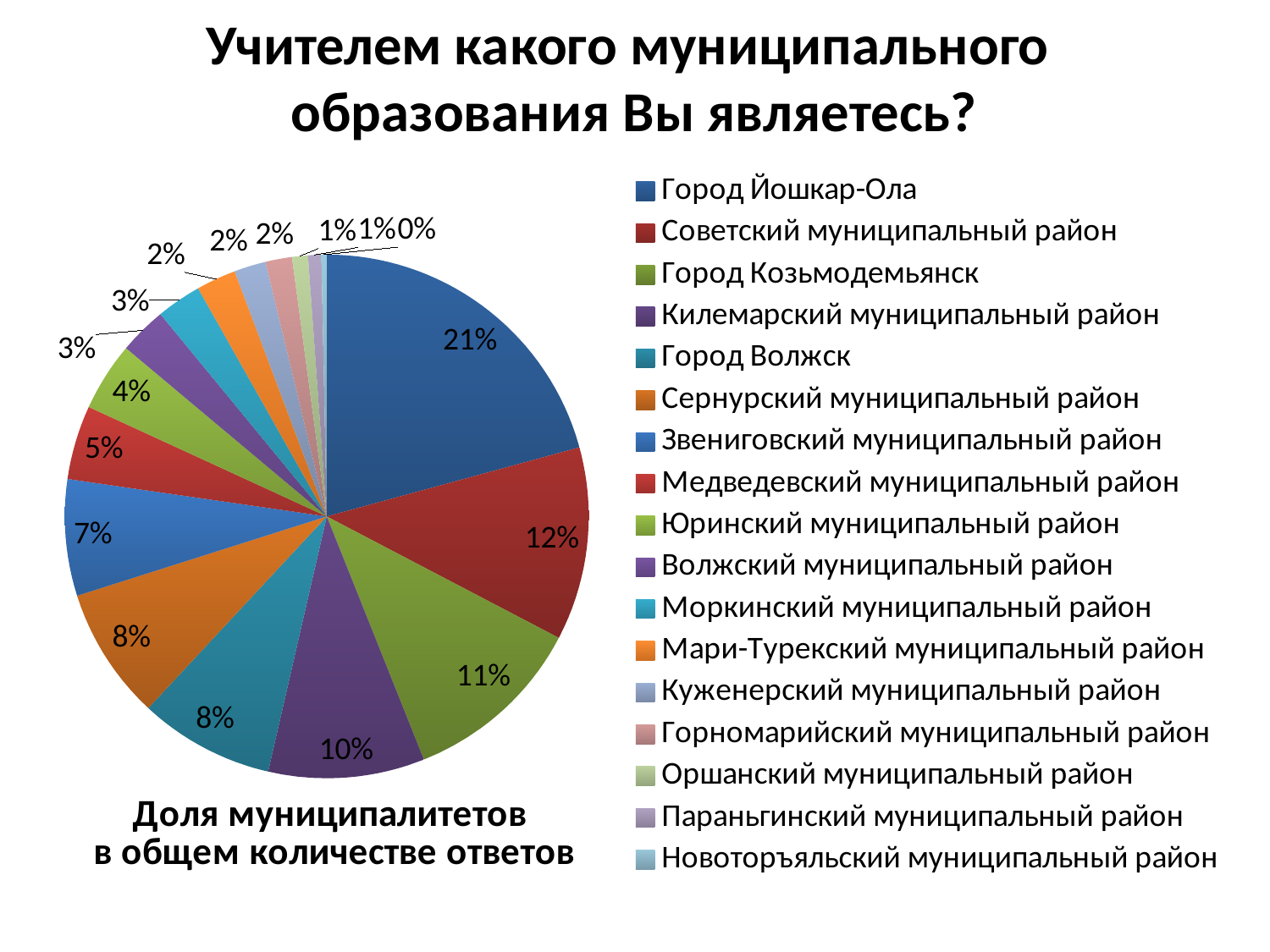
What share of responses does Медведевский муниципальный район account for? 5% Which has a larger share: Город Козьмодемьянск or Юринский муниципальный район? Город Козьмодемьянск What type of chart is shown on the slide? Pie chart What share of responses does Килемарский муниципальный район account for? 10% Which municipality has the smallest share of responses? Новоторъяльский муниципальный район What is the difference in share between Город Йошкар-Ола and Советский муниципальный район? 9 percentage points What share of responses does Советский муниципальный район account for? 12% What share of responses does Город Йошкар-Ола account for? 21% What is the caption shown below the pie chart? Доля муниципалитетов в общем количестве ответов Which municipality has the largest share of responses? Город Йошкар-Ола What share of responses does Звениговский муниципальный район account for? 7% How many municipalities are listed in the legend? 17